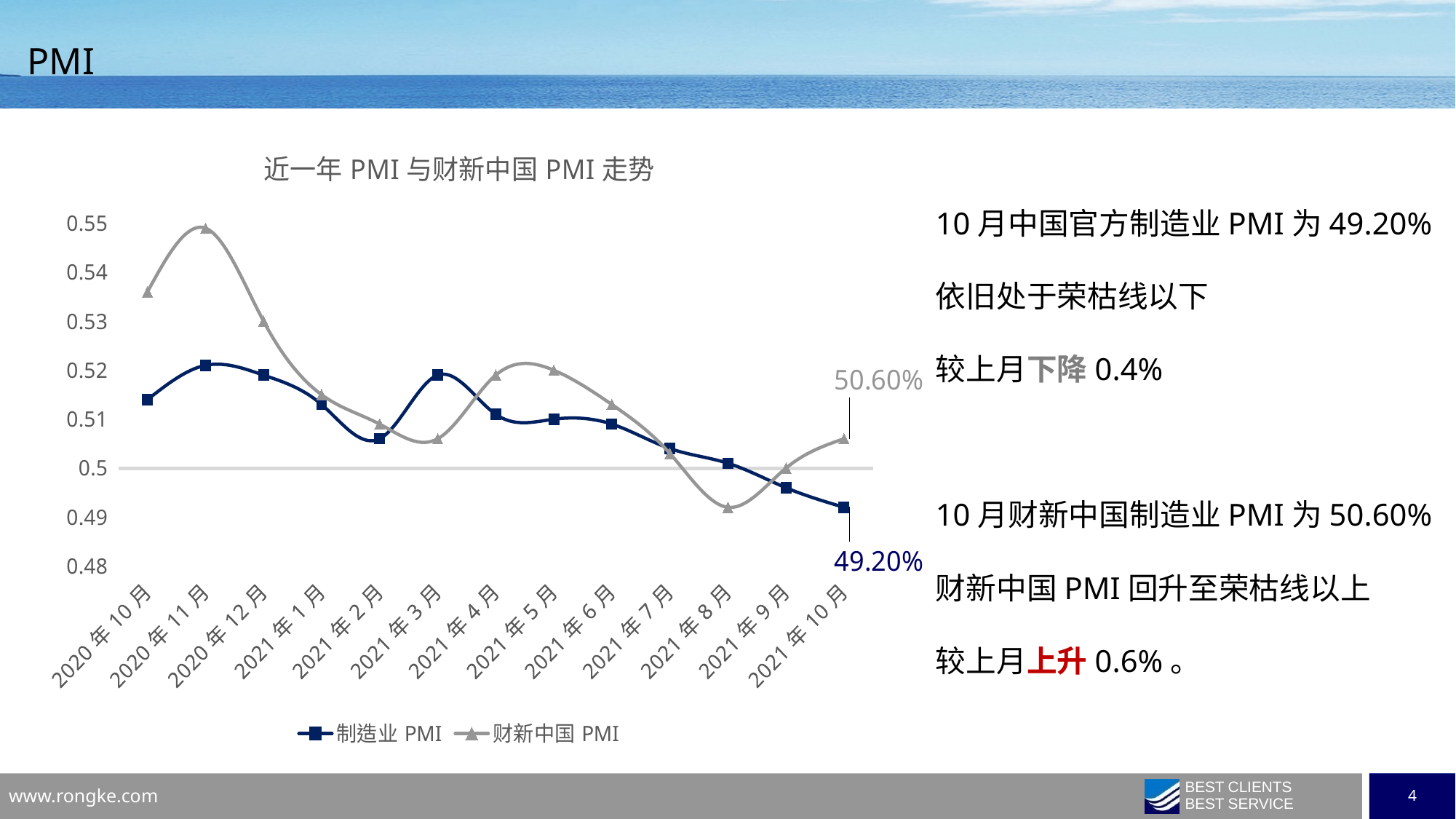
How many months are plotted along the x axis? 13 How many series does the legend list? 2 Does 制造业 PMI rise or fall from 2021年3月 to 2021年10月? fall Is the value of 财新中国 PMI for 2020年11月 greater or less than 0.54? greater In which month does 制造业 PMI reach its lowest value? 2021年10月 In which month does 财新中国 PMI reach its highest value? 2020年11月 What kind of chart is shown on the slide? line chart What is the value of 制造业 PMI for 2021年10月? 49.20% For 2021年10月, which series has the larger value, 制造业 PMI or 财新中国 PMI? 财新中国 PMI What is the value of 财新中国 PMI for 2021年10月? 50.60% Is the value of 财新中国 PMI for 2021年8月 greater or less than 0.5? less What is the difference between the 财新中国 PMI and 制造业 PMI values labelled for 2021年10月? 1.40%